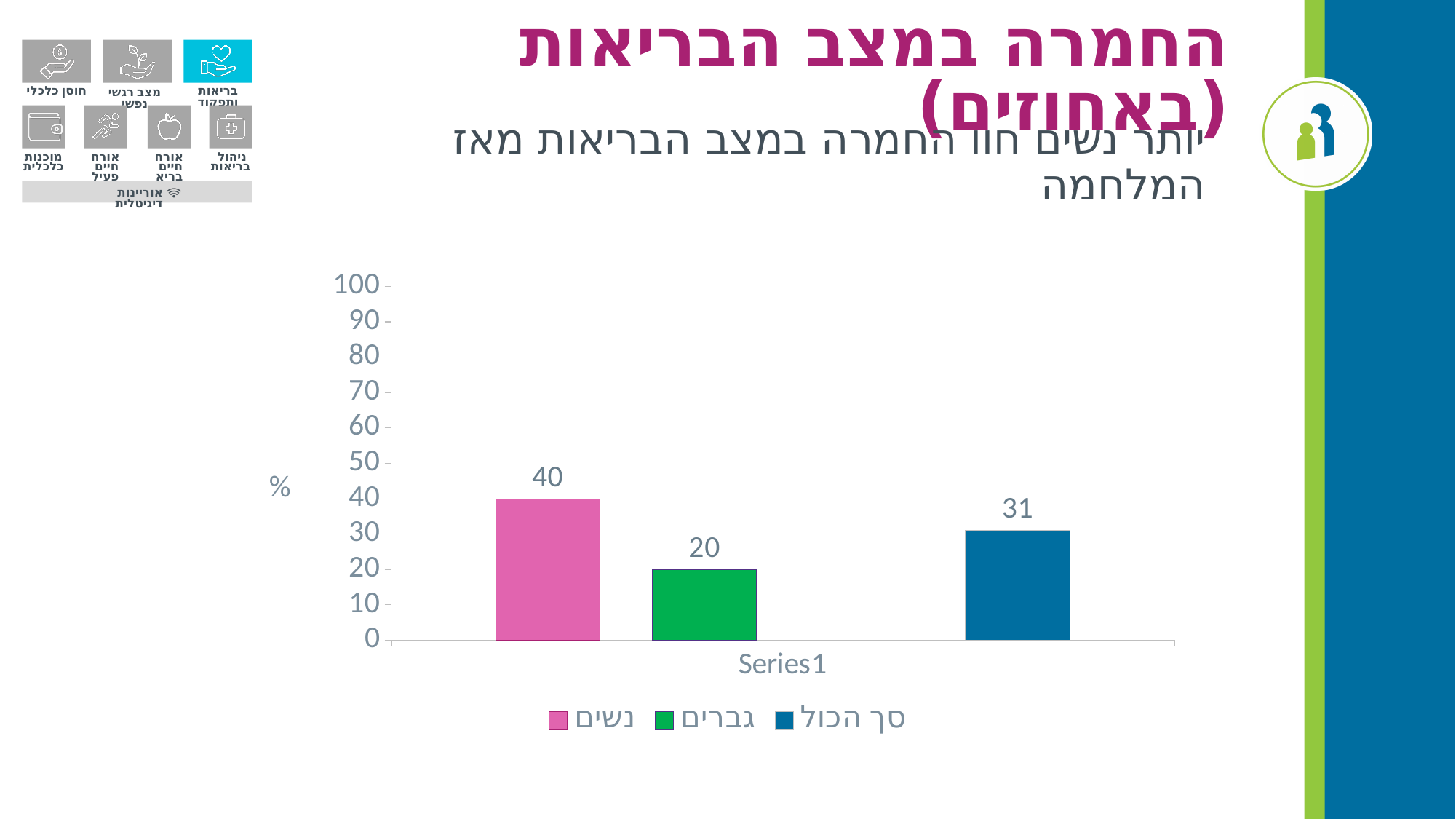
What is the difference between the values for נשים and גברים? 20 What kind of chart is shown on the slide? bar chart Is the value for סך הכול greater or less than 50? less What is the value for גברים (men) in the chart? 20 How many series does the legend list? 3 What is the value for נשים (women) in the chart? 40 What is the value for סך הכול (total) in the chart? 31 What is the difference between the values for נשים and סך הכול? 9 Which series has the lowest value in the chart? גברים Which series has the highest value in the chart? נשים What label is shown on the vertical axis of the chart? % Which is larger, the value for גברים or the value for סך הכול? סך הכול